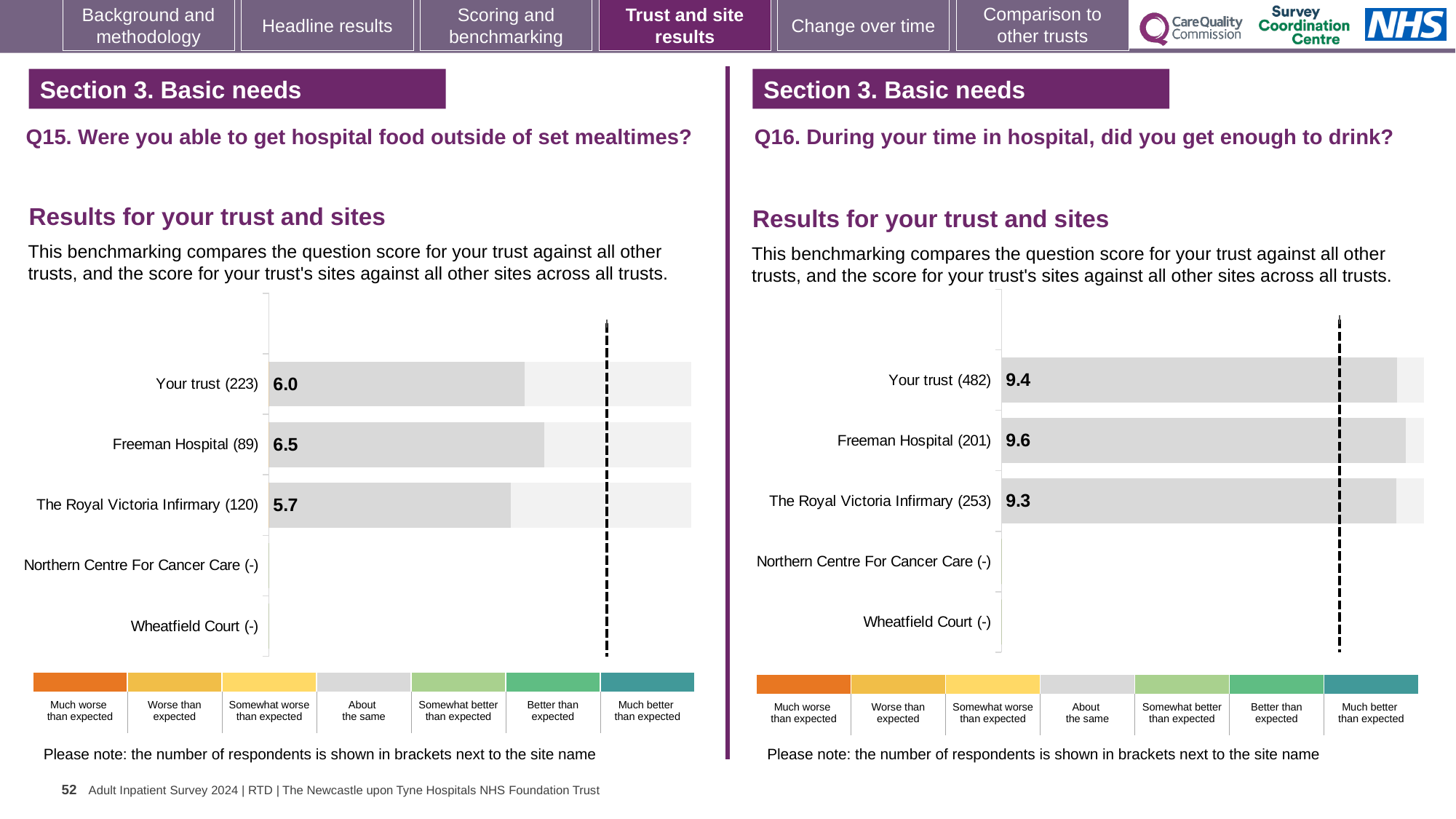
How many site/trust categories are listed on the Q15 chart (hospital food outside of set mealtimes)? 5 In the Q15 chart (hospital food outside of set mealtimes), what is the score for Freeman Hospital? 6.5 In the Q16 chart (enough to drink), what is the difference between the Your trust score and The Royal Victoria Infirmary score? 0.1 What kind of chart is used for the Q16 results (enough to drink)? Bar chart In the Q15 chart (hospital food outside of set mealtimes), what is the score for Your trust? 6.0 In the Q15 chart (hospital food outside of set mealtimes), what is the difference between the Freeman Hospital score and The Royal Victoria Infirmary score? 0.8 In the Q15 chart (hospital food outside of set mealtimes), what is the score for The Royal Victoria Infirmary? 5.7 In the Q16 chart (enough to drink), which site has the lowest score among those with a score shown? The Royal Victoria Infirmary In the Q15 chart (hospital food outside of set mealtimes), which site has the highest score? Freeman Hospital In the Q16 chart (enough to drink), what is the score for Your trust? 9.4 In the Q16 chart (enough to drink), which is larger: the score for Freeman Hospital or the score for The Royal Victoria Infirmary? Freeman Hospital In the Q16 chart (enough to drink), what is the score for Freeman Hospital? 9.6